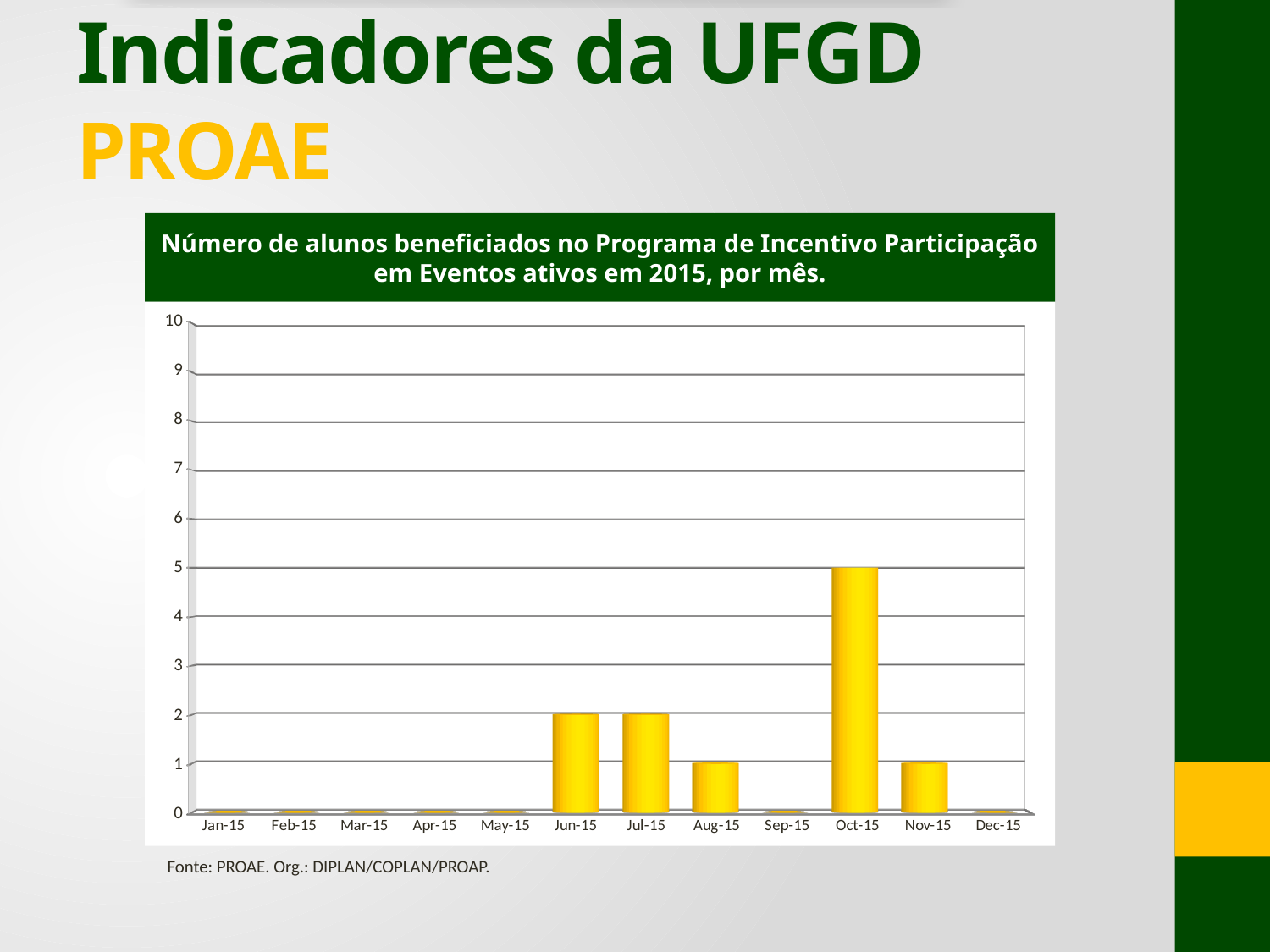
What is the value for Aug-15? 1 What is the difference between the values for Oct-15 and Jul-15? 3 What kind of chart is shown on the slide? bar chart What is the value for Jun-15? 2 What is the value for Sep-15? 0 What is the value for Oct-15? 5 How many months are shown on the x axis of the chart? 12 Which is larger, the value for Jun-15 or the value for Aug-15? Jun-15 Is the value for Oct-15 greater or less than 4? greater What is the title of the chart? Número de alunos beneficiados no Programa de Incentivo Participação em Eventos ativos em 2015, por mês. Which month has the highest number of students benefited? Oct-15 What is the value for Nov-15? 1